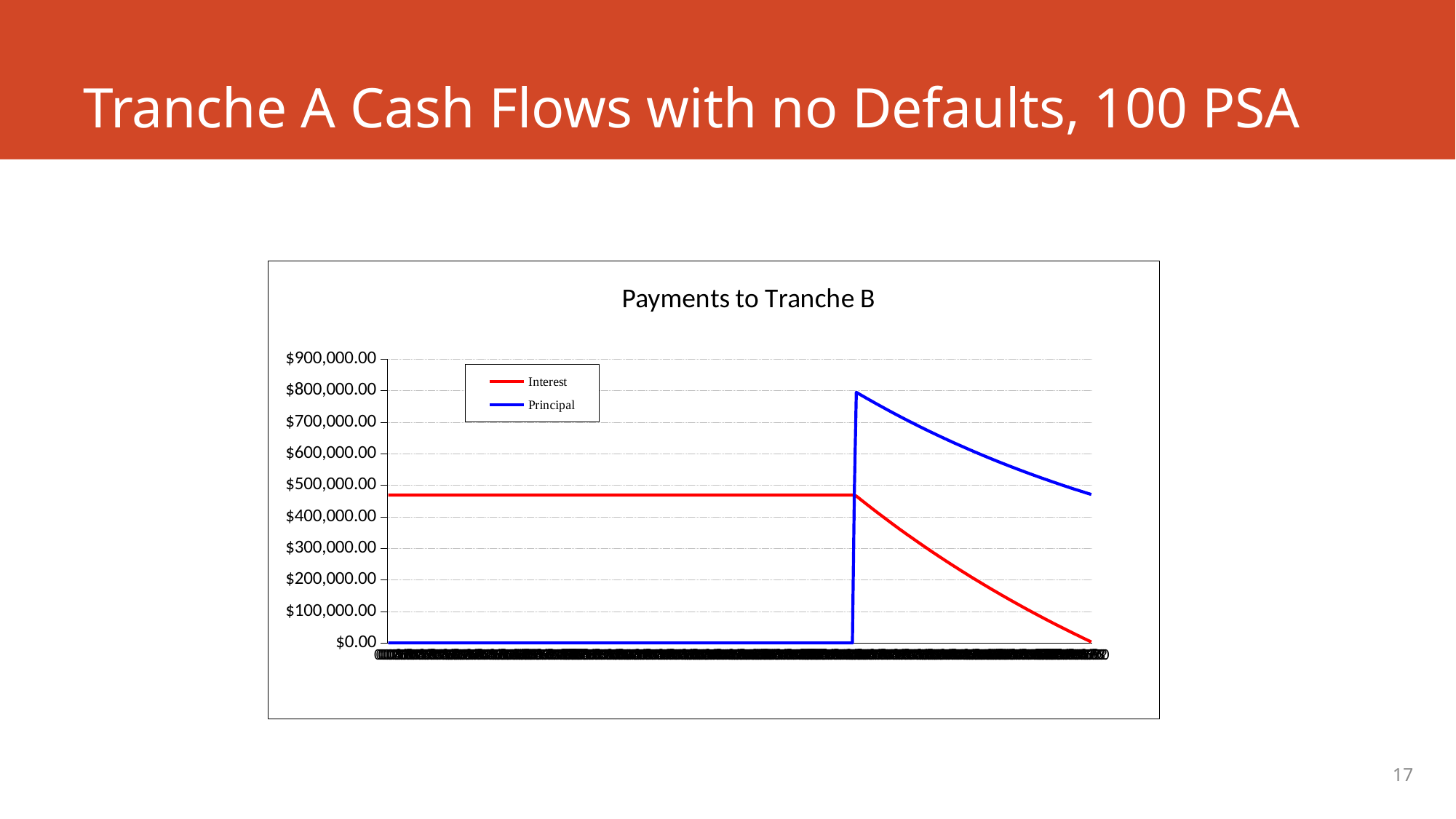
Which series reaches the highest value on the chart? Principal At the far right end of the chart, which series has the larger value, Interest or Principal? Principal Is the peak value of the Principal series greater or less than $700,000.00? greater Is the Interest value in the flat early portion of the chart greater or less than $500,000.00? less After the Principal series jumps up, does the Interest series rise or fall along the x axis? fall What is the title of the chart on the slide? Payments to Tranche B Is the Interest value in the flat early portion of the chart greater or less than $400,000.00? greater Which colour is used for the Principal series in the chart? blue How many series does the chart's legend list? 2 What kind of chart is shown on the slide? line chart